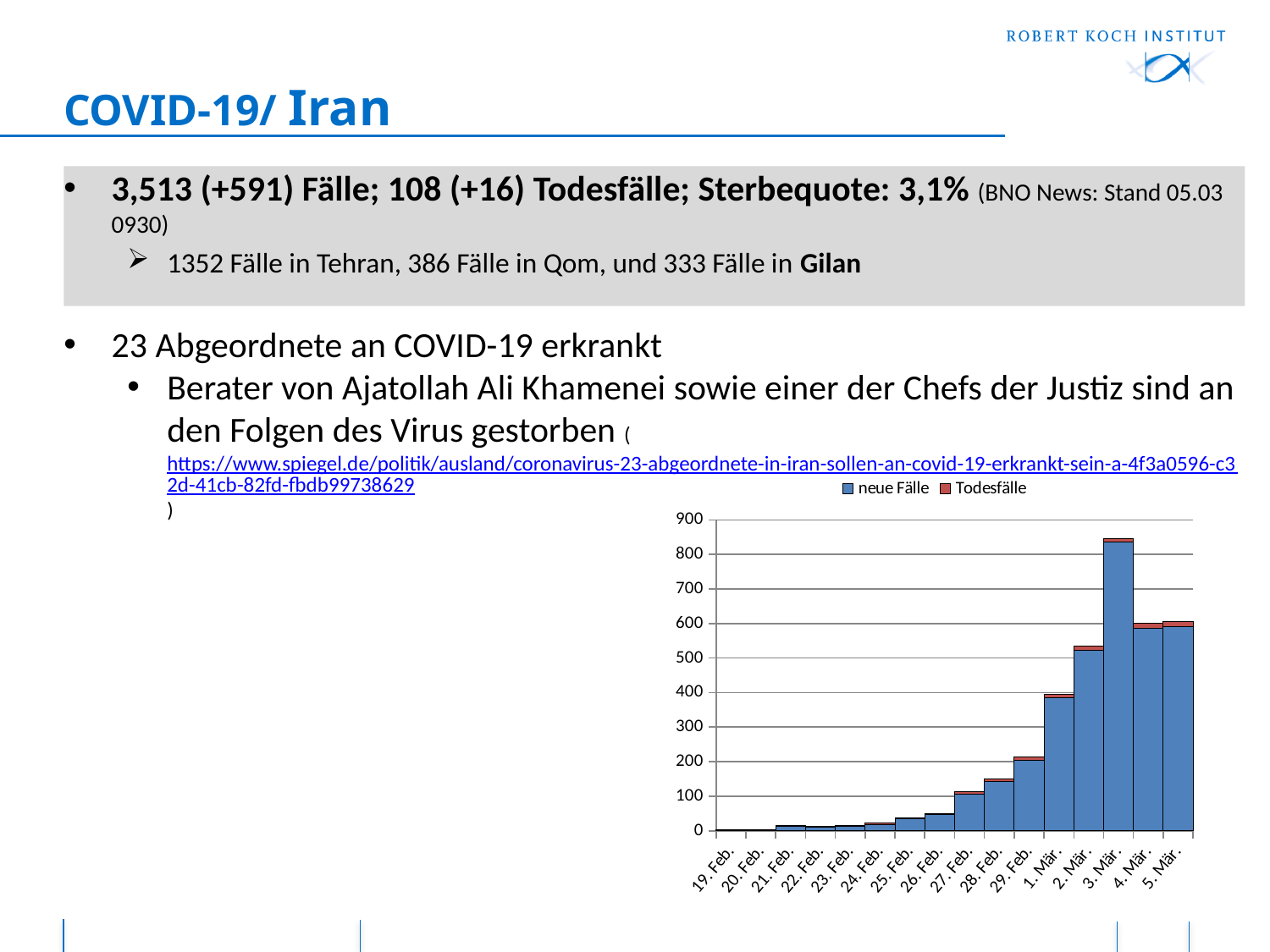
Is the total bar for 3. Mär. greater or less than 800? greater How many series does the chart legend list? 2 Which date has the tallest bar in the chart? 3. Mär. Is the total bar for 28. Feb. greater or less than 200? less Is the total bar for 2. Mär. greater or less than 600? less Which colour represents the series 'Todesfälle' in the chart? red What kind of chart is shown on the slide? bar chart Which bar is taller, 2. Mär. or 29. Feb.? 2. Mär. How many dates are shown along the x axis of the chart? 16 What are the two series named in the chart legend? neue Fälle and Todesfälle